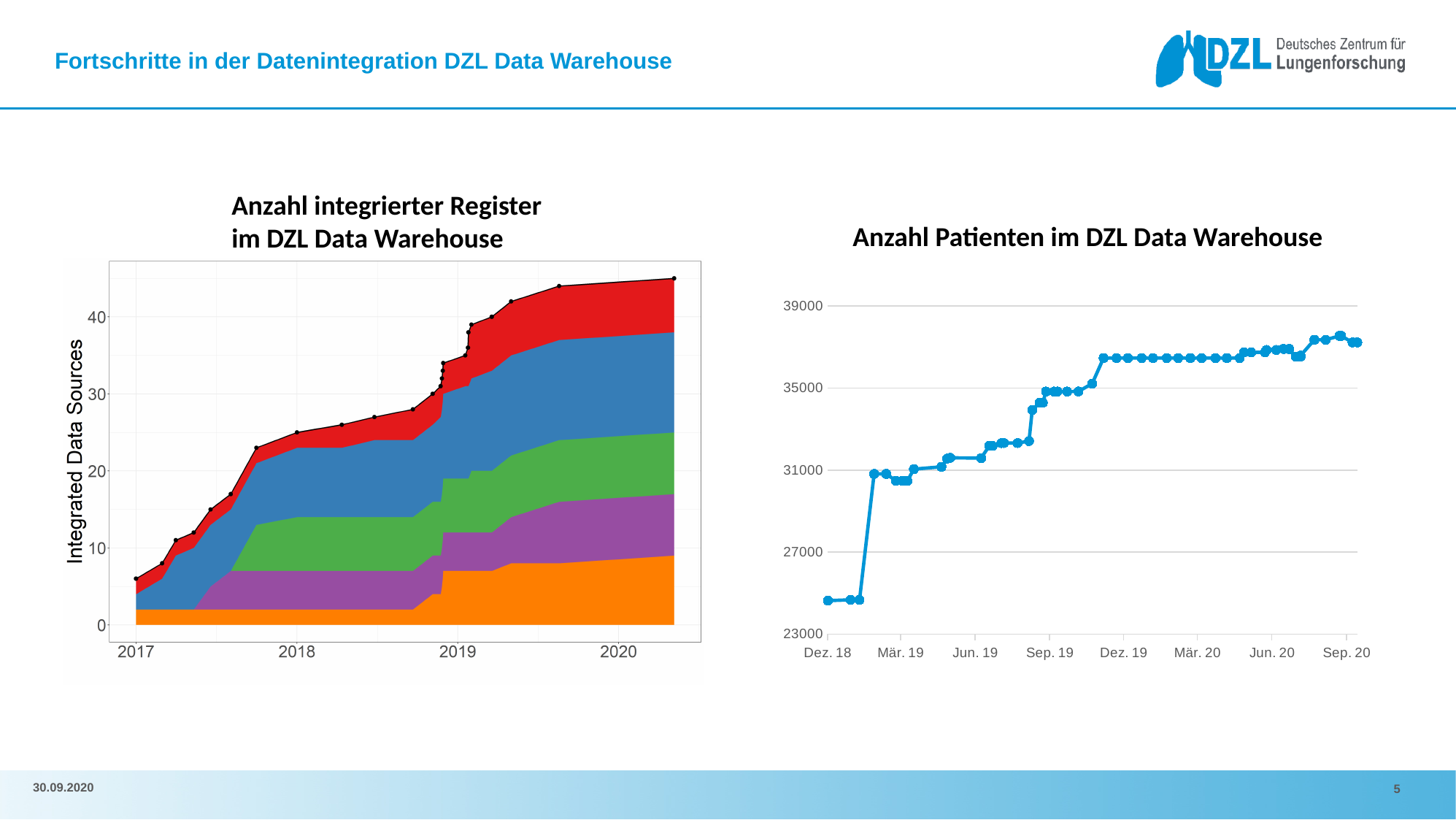
In 'Anzahl Patienten im DZL Data Warehouse', is the value at Dez. 19 greater or less than 35000? greater In 'Anzahl integrierter Register im DZL Data Warehouse', is the total number of integrated data sources at the start of 2017 greater or less than 10? less In 'Anzahl Patienten im DZL Data Warehouse', is the value at Dez. 18 greater or less than 27000? less How many coloured bands are stacked in the chart 'Anzahl integrierter Register im DZL Data Warehouse'? 5 In 'Anzahl integrierter Register im DZL Data Warehouse', does the total number of integrated data sources rise or fall from 2017 to 2020? rise What kind of chart is 'Anzahl Patienten im DZL Data Warehouse'? line chart What kind of chart is 'Anzahl integrierter Register im DZL Data Warehouse'? stacked area chart What is the y-axis label of the chart 'Anzahl integrierter Register im DZL Data Warehouse'? Integrated Data Sources In 'Anzahl Patienten im DZL Data Warehouse', does the number of patients rise or fall from Dez. 18 to Sep. 20? rise